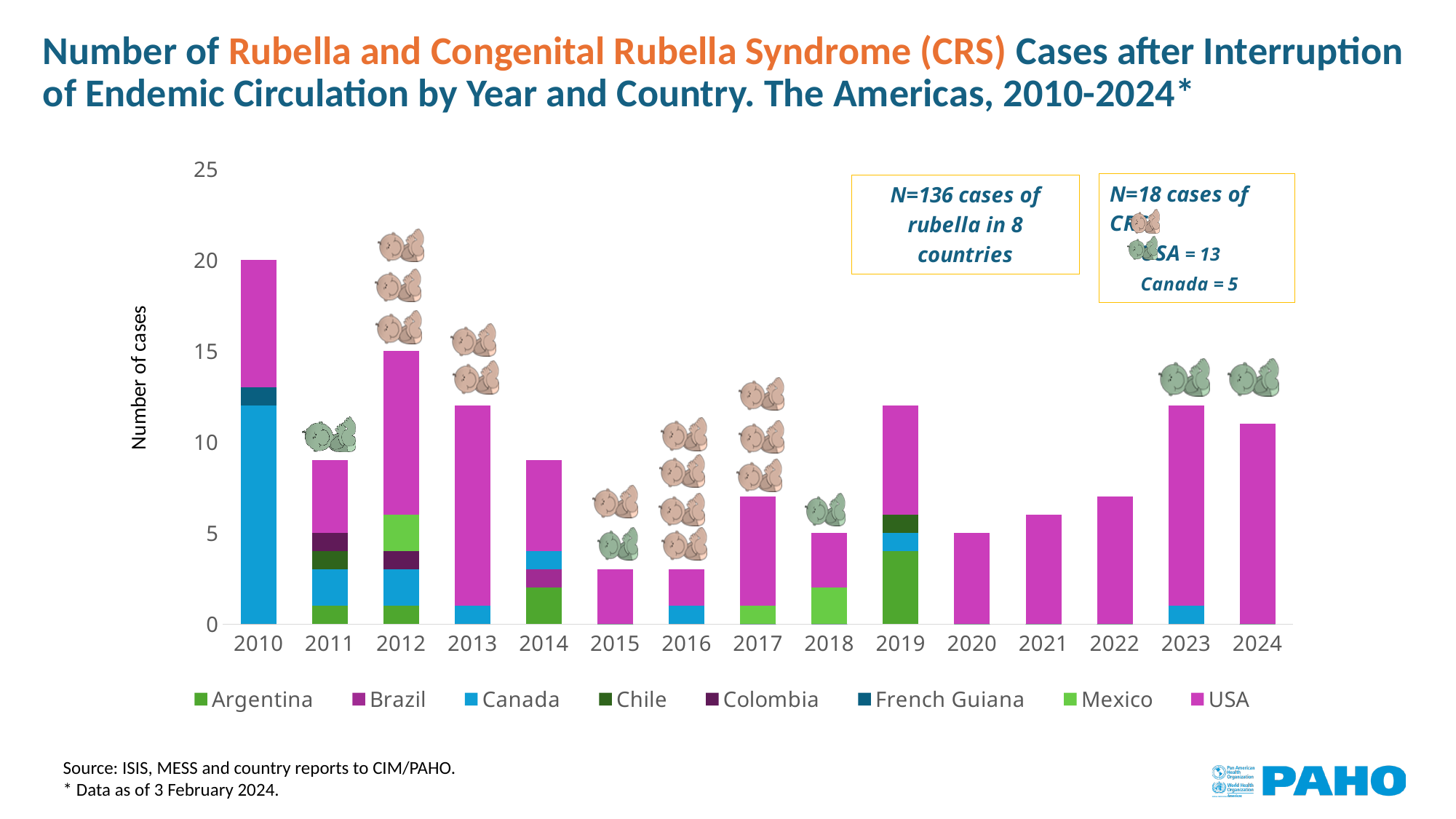
How many countries does the legend list? 8 What kind of chart is shown on the slide? Stacked bar chart Is the total number of cases in 2015 greater or less than 5? less What is the label on the y axis? Number of cases What is the total number of cases in 2020? 5 Which year has a larger total number of cases, 2010 or 2012? 2010 How many years (categories) are shown along the x axis? 15 What is the total number of cases in 2012? 15 Is the total number of cases in 2023 greater or less than 10? greater What is the total number of cases in 2010? 20 Which year has the highest total number of cases? 2010 Do the total number of cases rise or fall from 2020 to 2023? Rise